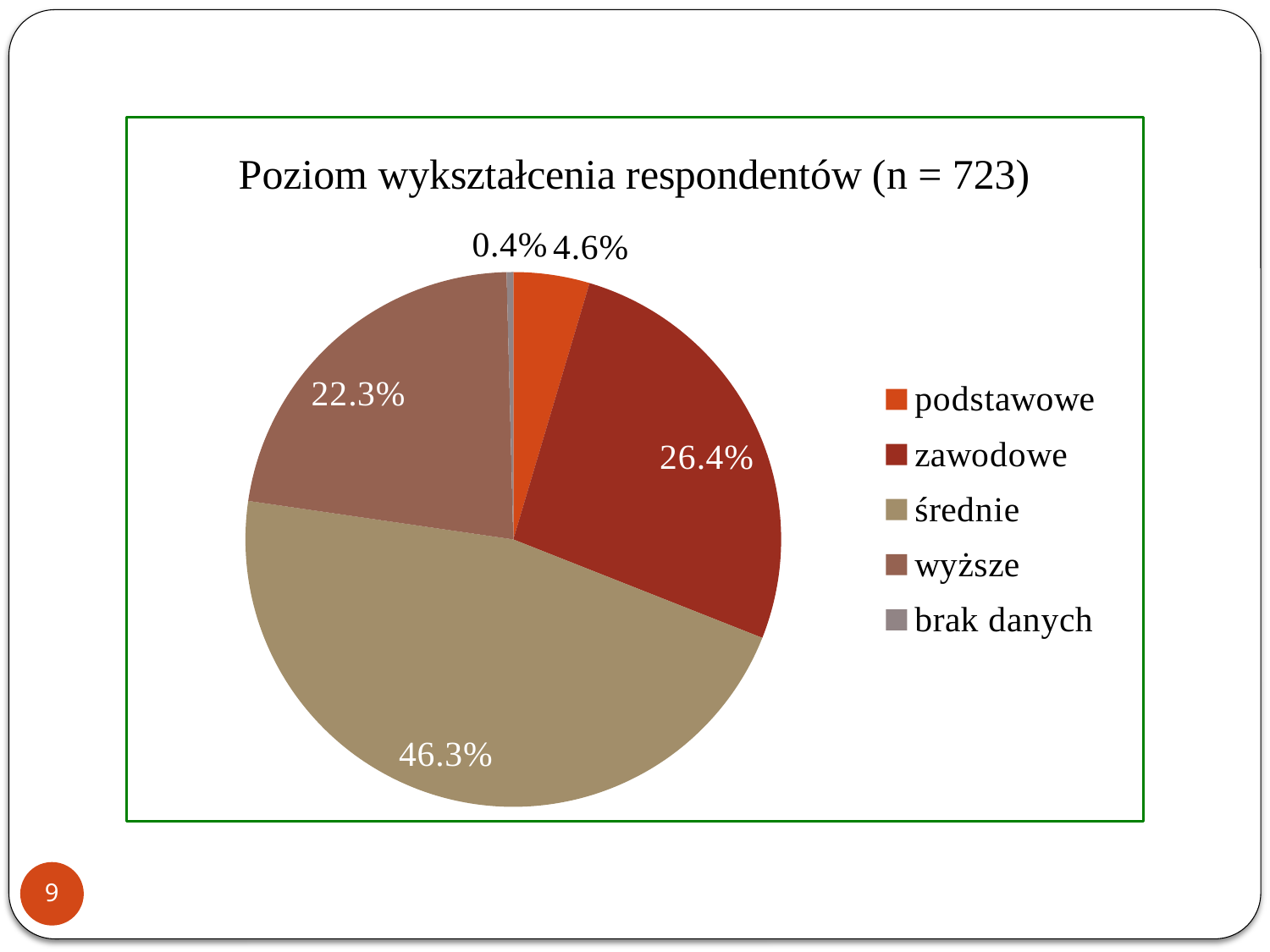
Which is larger, the share for 'zawodowe' or the share for 'wyższe'? zawodowe What share of respondents have 'zawodowe' education? 26.4% What share of respondents have 'wyższe' education? 22.3% Which category has the smallest share of respondents? brak danych What kind of chart is shown on the slide? pie chart How many categories does the legend list? 5 What share of respondents have 'średnie' education? 46.3% What share of respondents fall under 'brak danych'? 0.4% Which education level has the largest share of respondents? średnie What share of respondents have 'podstawowe' education? 4.6% What is the title of the chart? Poziom wykształcenia respondentów (n = 723) What is the difference in percentage points between 'średnie' and 'zawodowe'? 19.9